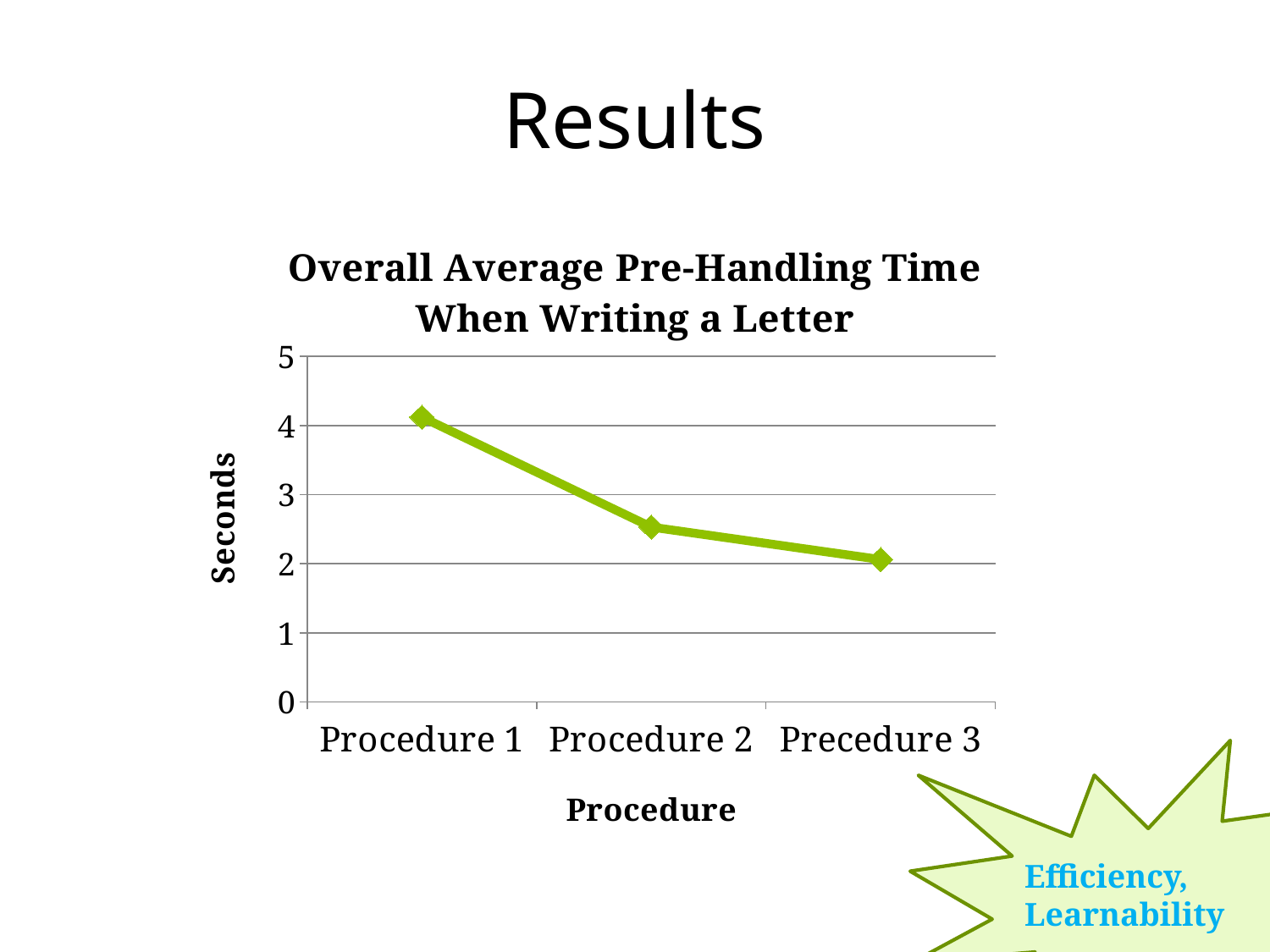
Do the values rise or fall from Procedure 1 to Precedure 3? fall Which has a higher value, Procedure 2 or Precedure 3? Procedure 2 Which procedure has the lowest average pre-handling time? Precedure 3 Is the value for Procedure 2 greater or less than 3? less Is the value for Procedure 1 greater or less than 3? greater Is the value for Procedure 2 greater or less than 2? greater Which has a higher value, Procedure 1 or Procedure 2? Procedure 1 What is the label on the vertical axis of the chart? Seconds Which procedure has the highest average pre-handling time? Procedure 1 What is the title of the chart? Overall Average Pre-Handling Time When Writing a Letter How many procedures are plotted on the chart? 3 What kind of chart is shown on the slide? line chart